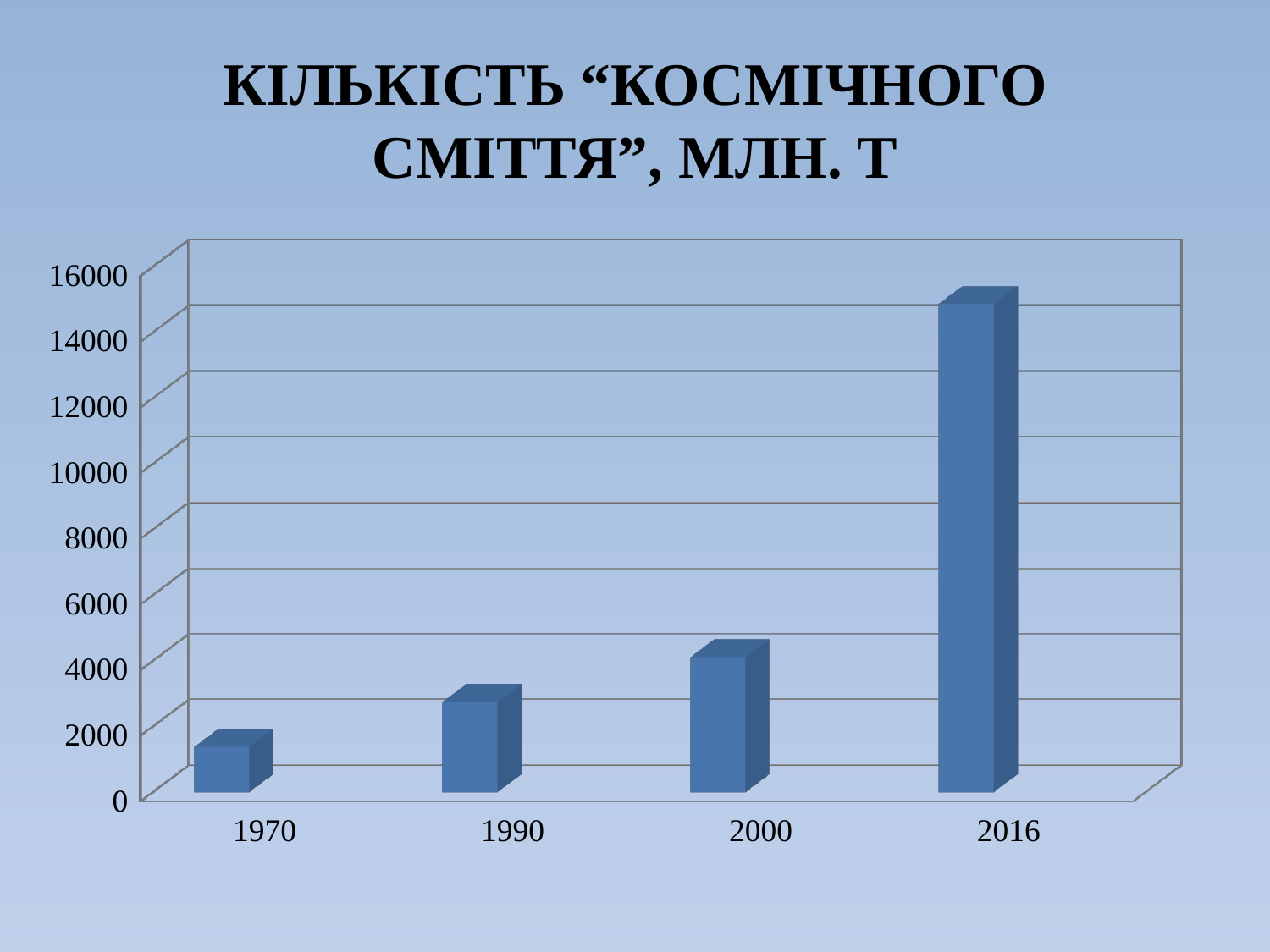
What kind of chart is shown on the slide? bar chart Which is larger, the value for 1970 or the value for 2000? 2000 What is the title of the chart? КІЛЬКІСТЬ “КОСМІЧНОГО СМІТТЯ”, МЛН. Т Is the value for 1990 greater or less than 6000? less Which is larger, the value for 1990 or the value for 2016? 2016 Do the values rise or fall from 1970 to 2016? rise Is the value for 2016 greater or less than 12000? greater Is the value for 1970 greater or less than 4000? less Which year has the highest amount of space debris? 2016 How many years are shown on the x axis of the chart? 4 Which year has the lowest amount of space debris? 1970